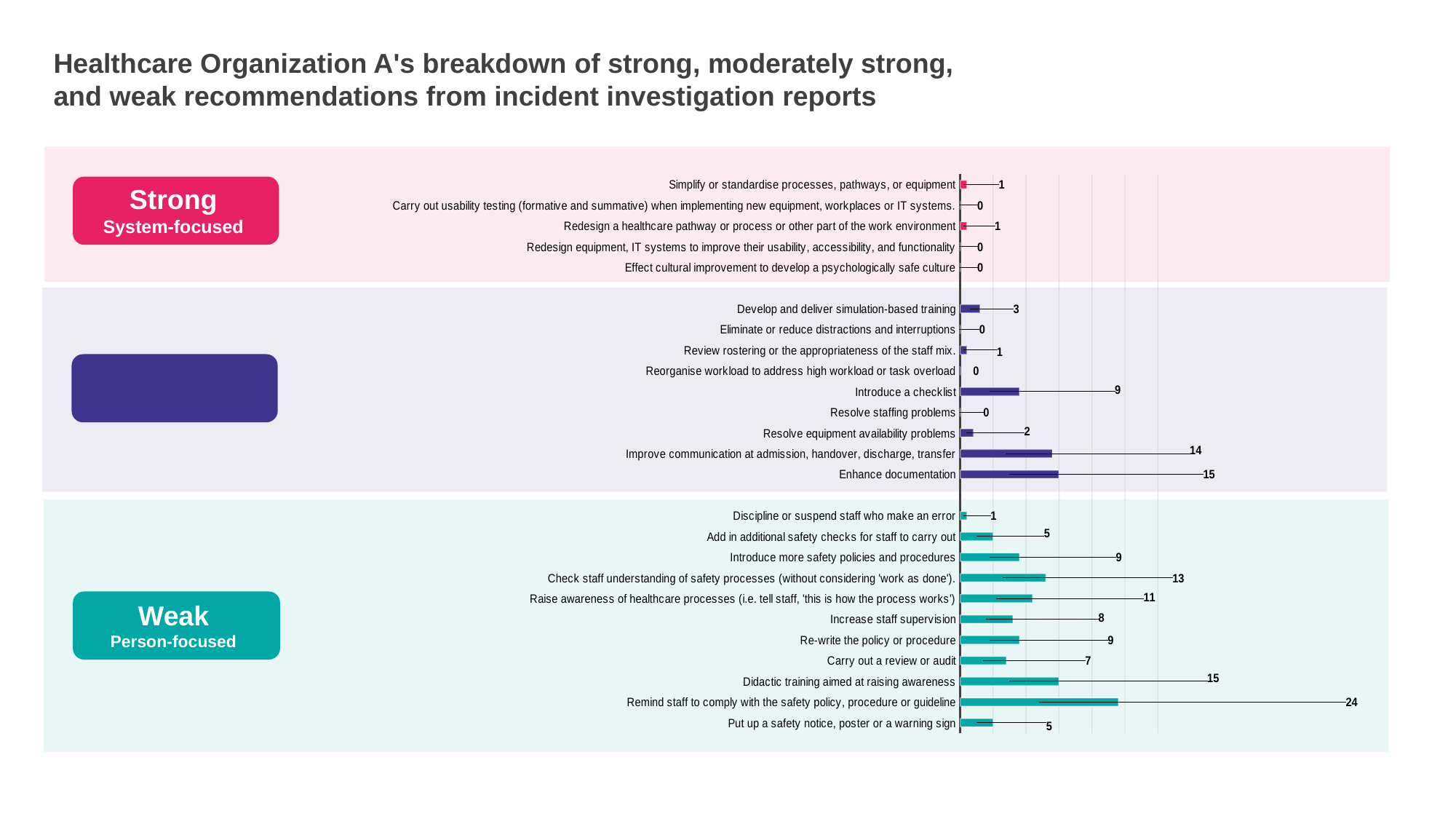
Which has a larger value, "Increase staff supervision" or "Raise awareness of healthcare processes (i.e. tell staff, 'this is how the process works')"? Raise awareness of healthcare processes (i.e. tell staff, 'this is how the process works') What is the difference between the values for "Enhance documentation" and "Improve communication at admission, handover, discharge, transfer"? 1 What type of chart is shown on the slide? bar chart What is the value for "Simplify or standardise processes, pathways, or equipment"? 1 What is the value for "Enhance documentation"? 15 What is the value for "Check staff understanding of safety processes (without considering 'work as done')"? 13 What colour are the bars in the "Weak" (Person-focused) section? teal How many categories are plotted in the chart in total? 25 Which category has the highest value in the chart? Remind staff to comply with the safety policy, procedure or guideline What is the difference between the values for "Remind staff to comply with the safety policy, procedure or guideline" and "Didactic training aimed at raising awareness"? 9 What is the value for "Introduce a checklist"? 9 What is the value for "Remind staff to comply with the safety policy, procedure or guideline"? 24